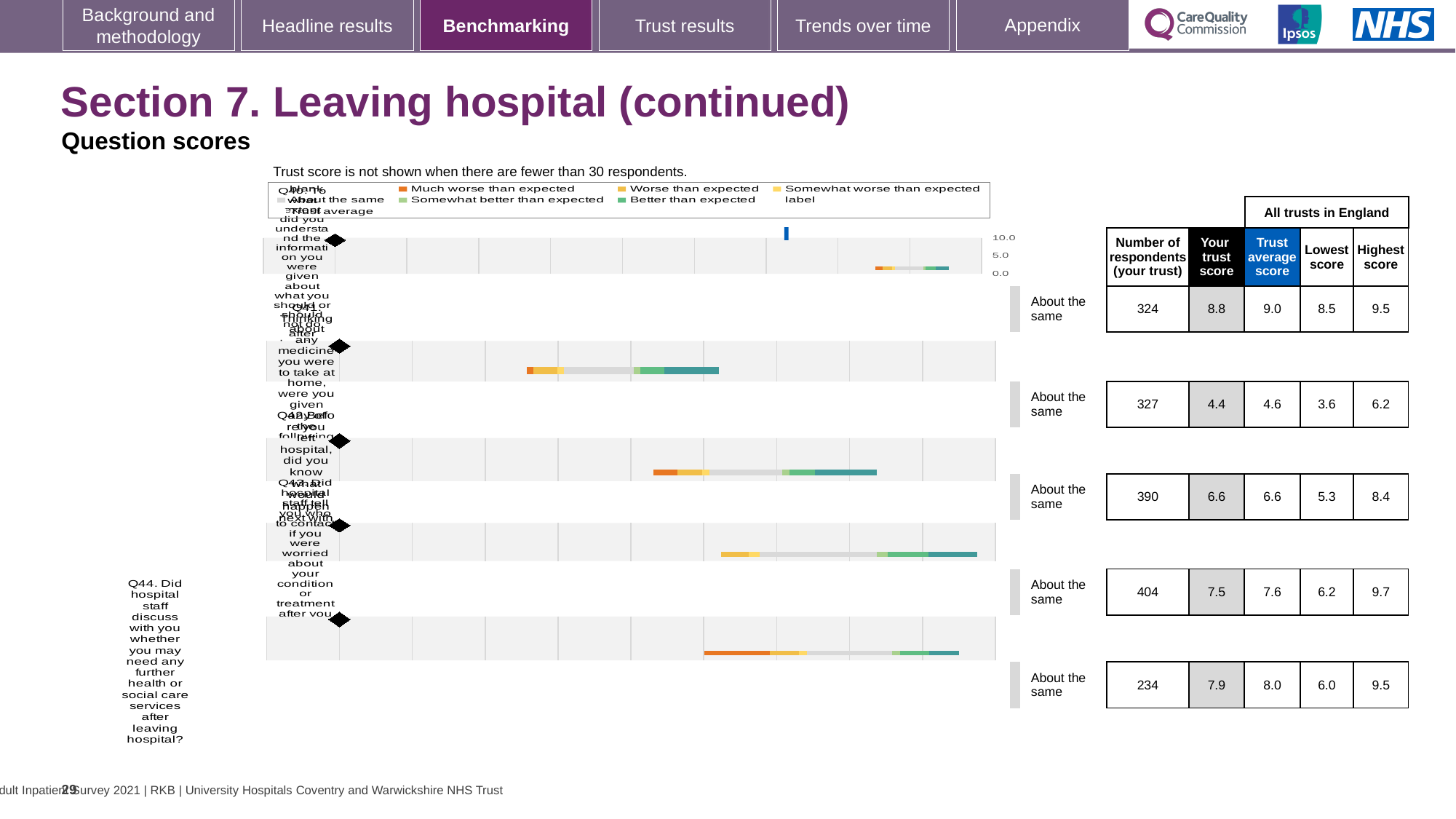
What is the number of respondents for the first (top) question row in the table? 324 How many question rows are shown in the benchmarking chart and table on this slide? 5 What is the 'Your trust score' for Q44 (further health or social care services after leaving hospital)? 7.9 What is the trust average score for Q44 in the table? 8.0 What is the largest number of respondents shown in the table for any question on this slide? 404 In the table, how many respondents (your trust) are shown for Q44 about discussing further health or social care services after leaving hospital? 234 What is the 'Your trust score' for the top question row in the table? 8.8 What benchmark category label is shown next to every question on this slide? About the same What is the lowest 'Your trust score' shown in the table on this slide? 4.4 What is the highest score across all trusts in England for Q44? 9.5 For Q44, what is the difference between the highest score and the lowest score across all trusts in England? 3.5 For Q44, is the 'Your trust score' higher or lower than the trust average score? lower